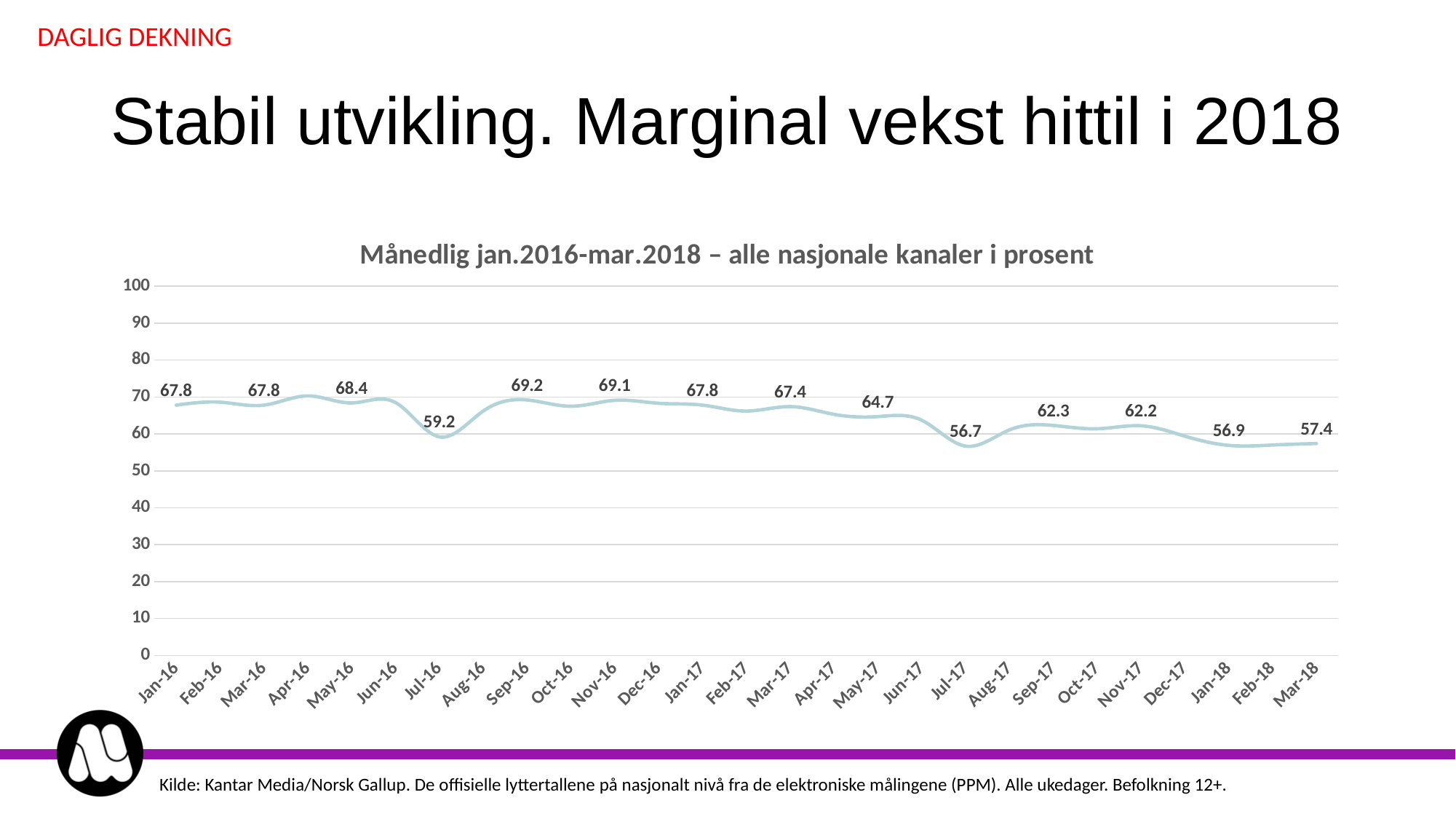
Which is lower, the value for Jul-17 or the value for Sep-17? Jul-17 What is the value for Mar-18? 57.4 Which is higher, the value for Sep-16 or the value for Jul-16? Sep-16 What is the value for Sep-16? 69.2 What is the difference between the value for Sep-16 and the value for Jul-16? 10.0 What is the title of the chart? Månedlig jan.2016-mar.2018 – alle nasjonale kanaler i prosent What is the value for Jul-17? 56.7 What kind of chart is shown on the slide? line chart How many months are plotted on the x axis? 27 What is the value for May-17? 64.7 What is the difference between the value for Jan-16 and the value for Mar-18? 10.4 Is the value for Aug-16 greater or less than 60? greater